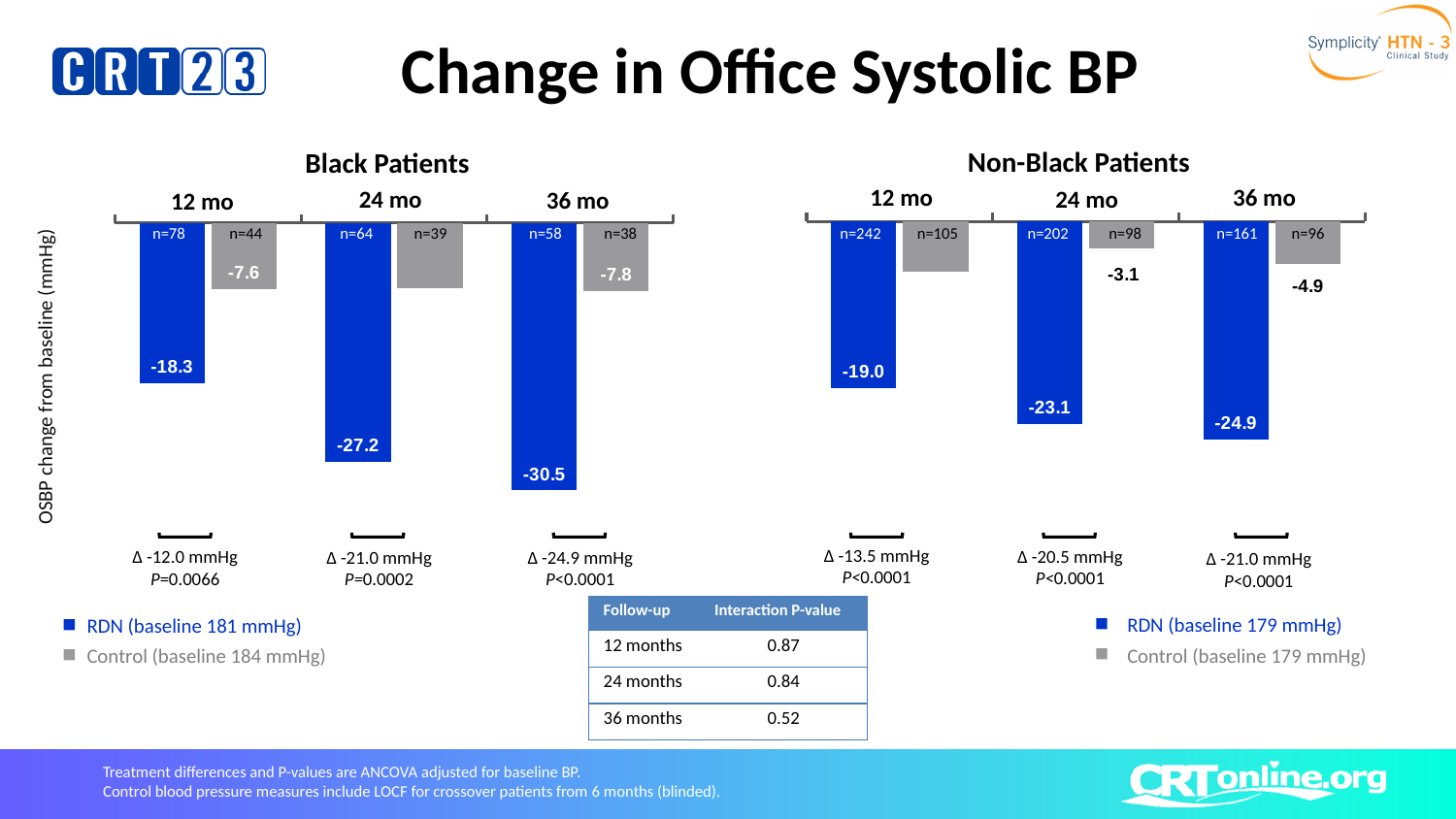
In the Black Patients chart, what is the difference between the RDN values at 36 mo and 12 mo? 12.2 In the Black Patients chart, what is the RDN value at 36 mo? -30.5 How many series does the legend of the Black Patients chart list? 2 In the Black Patients chart, what is the Control value at 12 mo? -7.6 In the Non-Black Patients chart, what is the RDN value at 24 mo? -23.1 In the Non-Black Patients chart, at which time point is the RDN bar least negative? 12 mo In the Non-Black Patients chart, which is more negative at 36 mo, RDN or Control? RDN What type of chart is used for the Black Patients data? Bar chart In the Black Patients chart, what is the RDN value at 12 mo? -18.3 In the Black Patients chart, at which time point is the RDN bar lowest (most negative)? 36 mo How many time points are shown in the Non-Black Patients chart? 3 In the Non-Black Patients chart, what is the Control value at 36 mo? -4.9